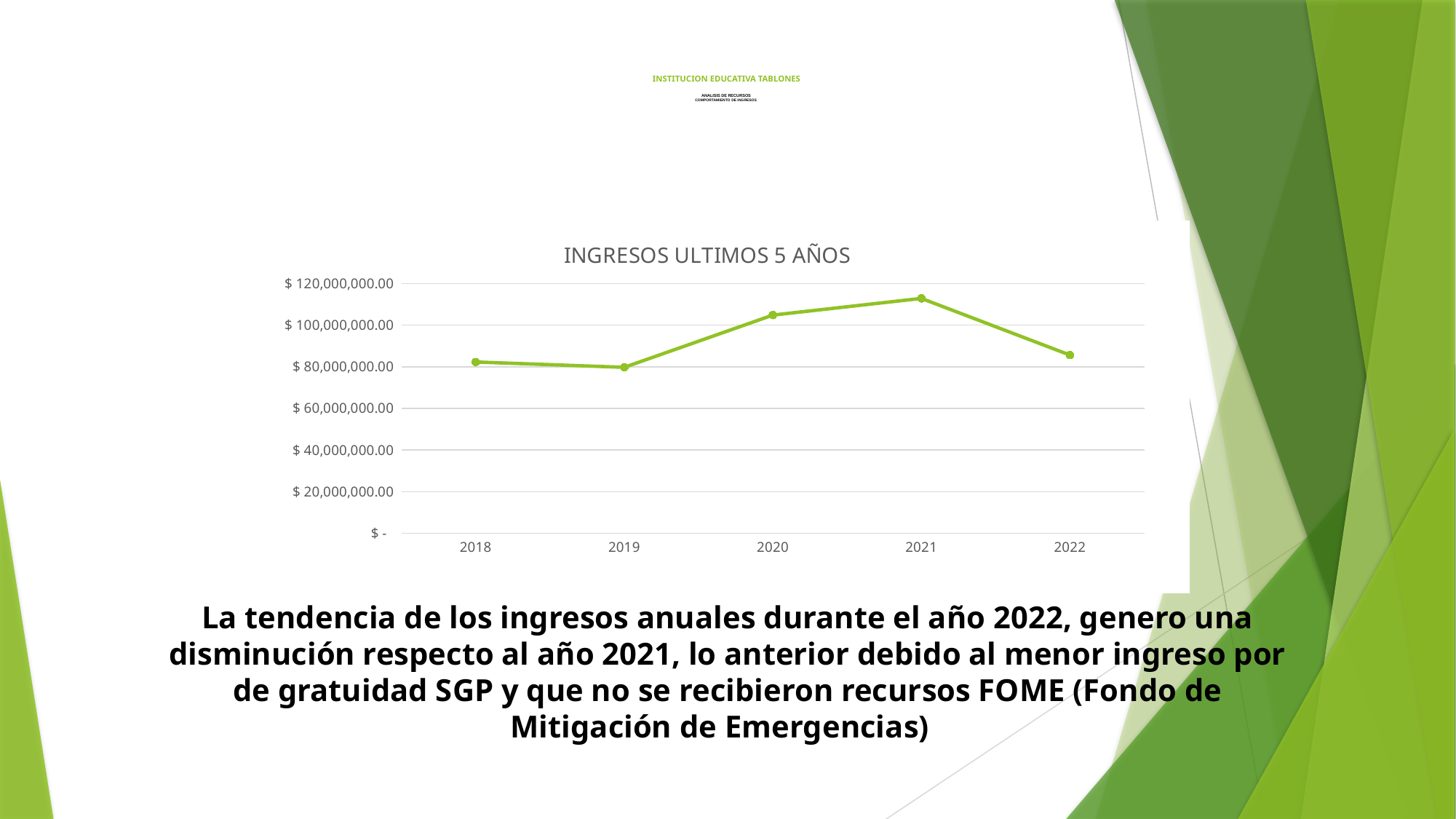
Is the value for 2019 greater or less than $ 100,000,000.00? less Do the values rise or fall from 2021 to 2022? fall How many years are plotted on the x axis of the chart? 5 Which year has the highest value in the chart? 2021 Is the value for 2021 greater or less than $ 100,000,000.00? greater What kind of chart is shown on the slide? line chart Is the value for 2020 greater or less than $ 100,000,000.00? greater What is the title of the chart? INGRESOS ULTIMOS 5 AÑOS Which is larger, the value for 2020 or the value for 2018? 2020 Which is larger, the value for 2021 or the value for 2022? 2021